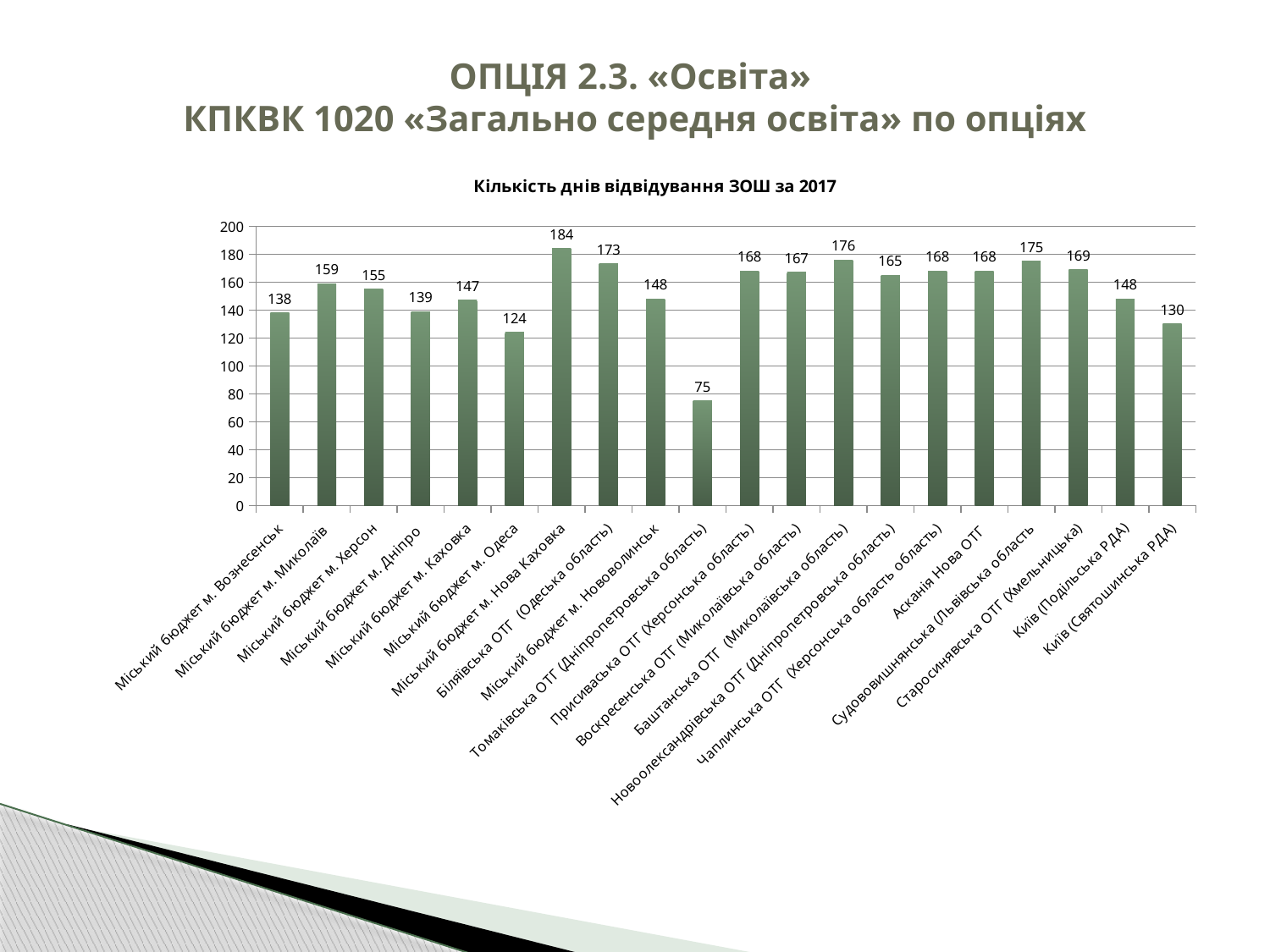
How many categories are shown on the chart? 20 What is the difference between the values for Міський бюджет м. Миколаїв and Міський бюджет м. Одеса? 35 Which category has the lowest value? Томаківська ОТГ (Дніпропетровська область) What is the title of the chart? Кількість днів відвідування ЗОШ за 2017 Is the value for Міський бюджет м. Дніпро greater or less than 160? less What kind of chart is shown on the slide? bar chart What is the value for Міський бюджет м. Нова Каховка? 184 What is the value for Київ (Святошинська РДА)? 130 Which category has the highest value? Міський бюджет м. Нова Каховка What is the value for Томаківська ОТГ (Дніпропетровська область)? 75 What is the value for Баштанська ОТГ (Миколаївська область)? 176 Which is larger: the value for Біляївська ОТГ (Одеська область) or the value for Старосинявська ОТГ (Хмельницька)? Біляївська ОТГ (Одеська область)